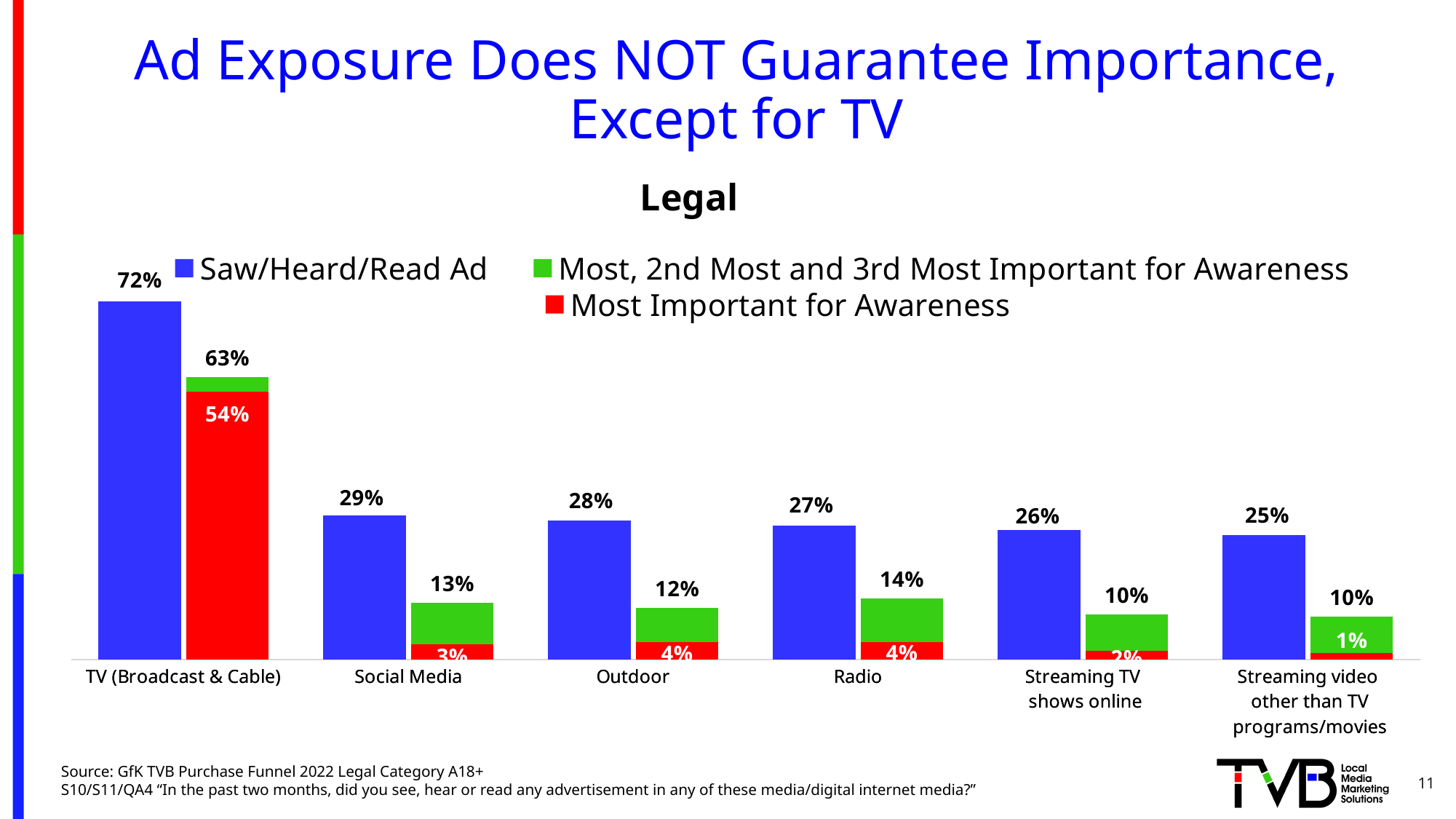
What is the difference between the Saw/Heard/Read Ad value and the Most Important for Awareness value for TV (Broadcast & Cable)? 18% What kind of chart is shown on the slide? Bar chart What is the Saw/Heard/Read Ad value for Streaming video other than TV programs/movies? 25% Which is larger for Social Media: the Saw/Heard/Read Ad value or the Most, 2nd Most and 3rd Most Important for Awareness value? Saw/Heard/Read Ad Which category has the lowest Most Important for Awareness value? Streaming video other than TV programs/movies How many media categories are shown on the x axis? 6 Which category has the highest Saw/Heard/Read Ad value? TV (Broadcast & Cable) What is the Most Important for Awareness value for TV (Broadcast & Cable)? 54% What percentage of respondents Saw/Heard/Read Ad for TV (Broadcast & Cable)? 72% How many series does the legend list? 3 What is the Most, 2nd Most and 3rd Most Important for Awareness value for Radio? 14% What is the title of the chart? Legal